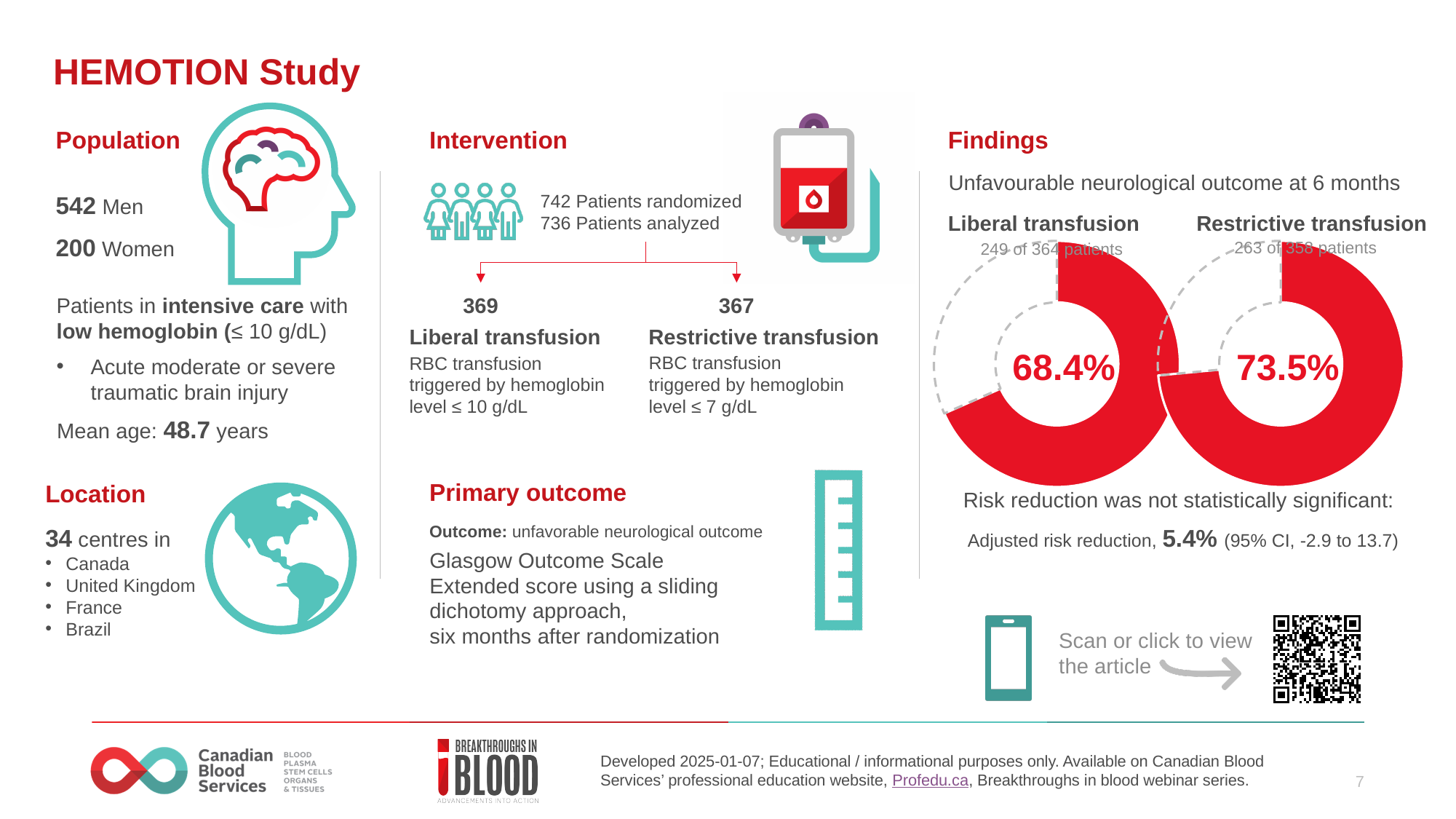
What colour is the filled portion of the donut charts in the Findings section? Red In the Findings section, what percentage is shown in the Liberal transfusion donut chart? 68.4% How many donut charts are shown in the Findings section? 2 In the Findings section, what percentage is shown in the Restrictive transfusion donut chart? 73.5% What outcome do the two donut charts in the Findings section represent? Unfavourable neurological outcome at 6 months What kind of chart is used to display the unfavourable neurological outcome percentages in the Findings section? Donut (pie) chart According to the label above the Restrictive transfusion donut chart, how many patients out of how many had an unfavourable outcome? 263 of 358 patients What is the difference in percentage points between the Restrictive transfusion chart (73.5%) and the Liberal transfusion chart (68.4%)? 5.1% Which of the two donut charts in the Findings section shows the lower percentage? Liberal transfusion According to the label above the Liberal transfusion donut chart, how many patients out of how many had an unfavourable outcome? 249 of 364 patients Which group has the higher percentage of unfavourable neurological outcome at 6 months, Liberal transfusion or Restrictive transfusion? Restrictive transfusion